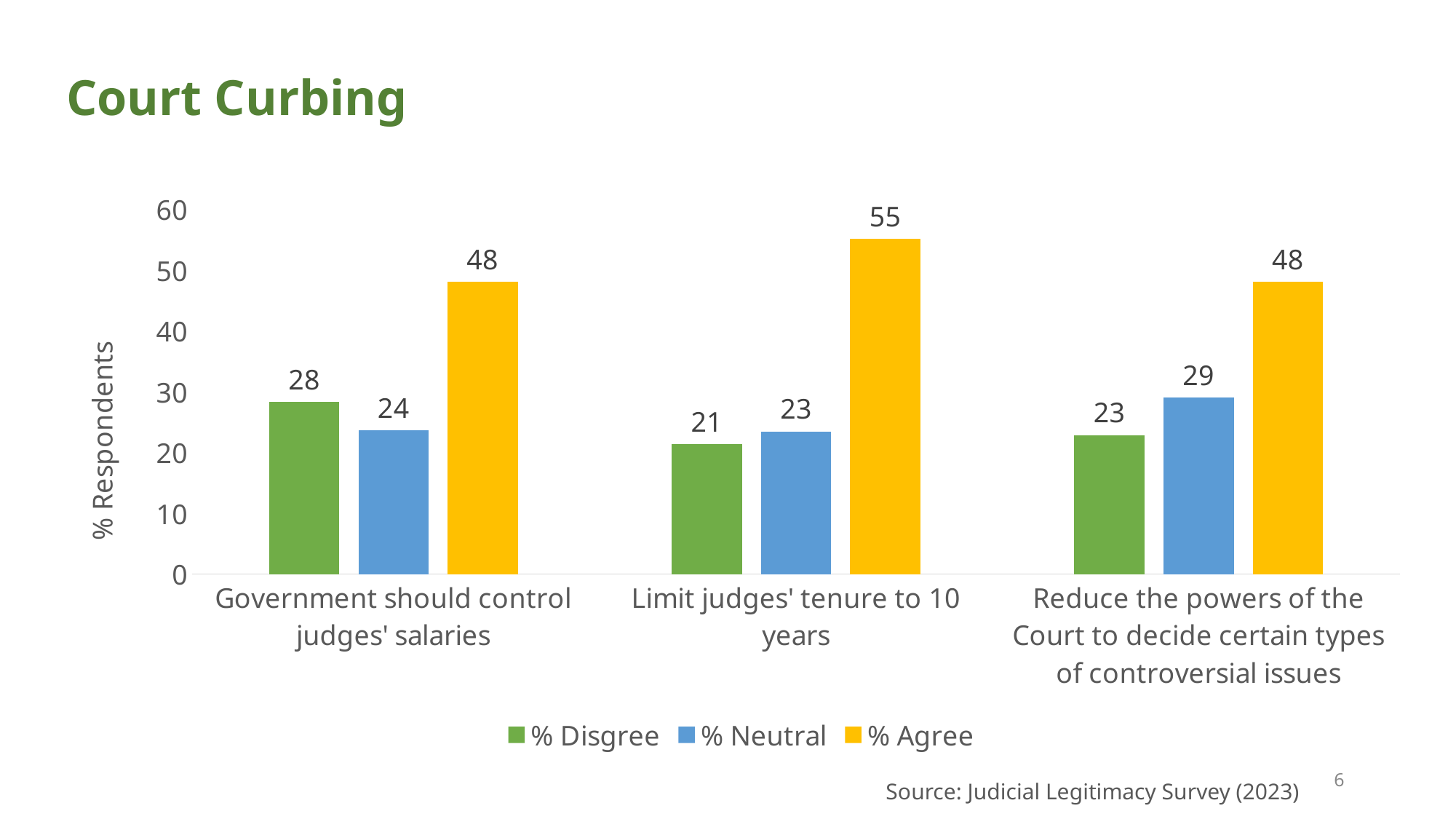
Which is larger for "Reduce the powers of the Court to decide certain types of controversial issues": % Neutral or % Disgree? % Neutral Which category has the highest % Agree value? Limit judges' tenure to 10 years Is the % Agree value for "Government should control judges' salaries" greater or less than 40? greater What is the label of the vertical axis? % Respondents What is the difference between the % Agree and % Disgree values for "Limit judges' tenure to 10 years"? 34 What is the % Neutral value for "Reduce the powers of the Court to decide certain types of controversial issues"? 29 How many categories are shown on the x axis? 3 Which category has the lowest % Disgree value? Limit judges' tenure to 10 years How many series does the legend list? 3 What is the % Disgree value for "Government should control judges' salaries"? 28 What is the % Agree value for "Limit judges' tenure to 10 years"? 55 What kind of chart is shown on the slide? Bar chart